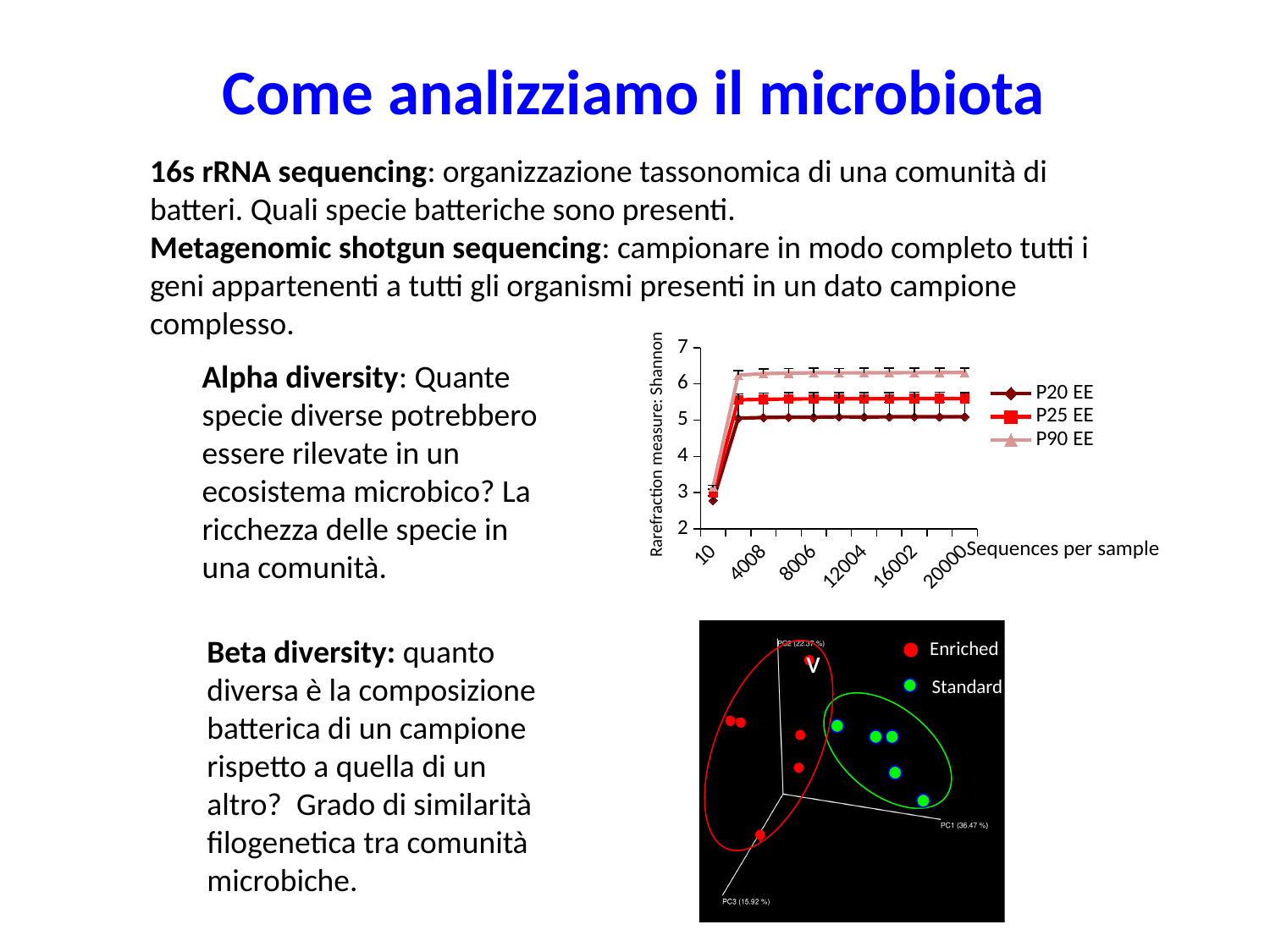
What kind of chart is the upper-right chart with the P20 EE, P25 EE and P90 EE series? line chart In the rarefaction line chart, how many tick labels are shown on the x axis? 6 In the rarefaction line chart, which series reaches the highest Shannon values? P90 EE In the rarefaction line chart, is the value for P20 EE at 20000 sequences per sample greater or less than 6? less In the rarefaction line chart, which is larger at 20000 sequences per sample: P90 EE or P20 EE? P90 EE In the rarefaction line chart (upper right), how many series does the legend list? 3 In the rarefaction line chart, do the Shannon values rise or fall as sequences per sample increase from 10 to 4008? rise In the rarefaction line chart, which series has the lowest Shannon values at 20000 sequences per sample? P20 EE In the rarefaction line chart, is the value for P90 EE at 20000 sequences per sample greater or less than 6? greater What is the y-axis label of the rarefaction line chart? Rarefraction measure: Shannon In the scatter plot at the bottom right, what are the two legend entries? Enriched and Standard In the rarefaction line chart, is the value for P25 EE at 20000 sequences per sample greater or less than 5? greater